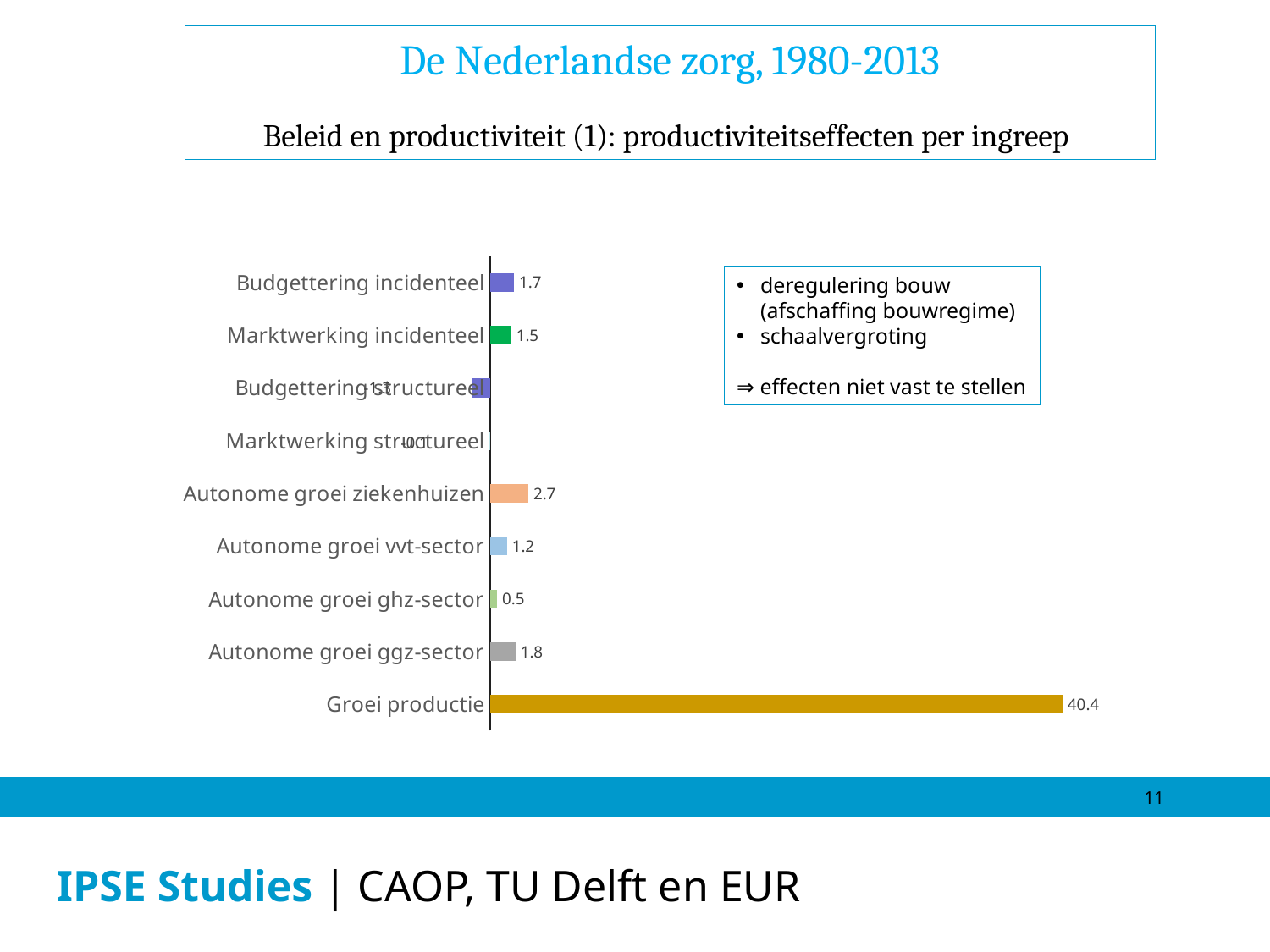
What is the value for Budgettering incidenteel? 1.7 Which is larger, Marktwerking incidenteel or Autonome groei ggz-sector? Autonome groei ggz-sector What kind of chart is shown on the slide? Bar chart What is the value for Autonome groei ghz-sector? 0.5 How many categories are shown in the chart? 9 What is the value for Groei productie? 40.4 What is the difference between Autonome groei ziekenhuizen and Autonome groei vvt-sector? 1.5 What is the difference between Groei productie and Autonome groei ggz-sector? 38.6 Which category has the lowest value? Budgettering structureel What is the value for Autonome groei ziekenhuizen? 2.7 Which category has the highest value? Groei productie What is the value for Autonome groei ggz-sector? 1.8